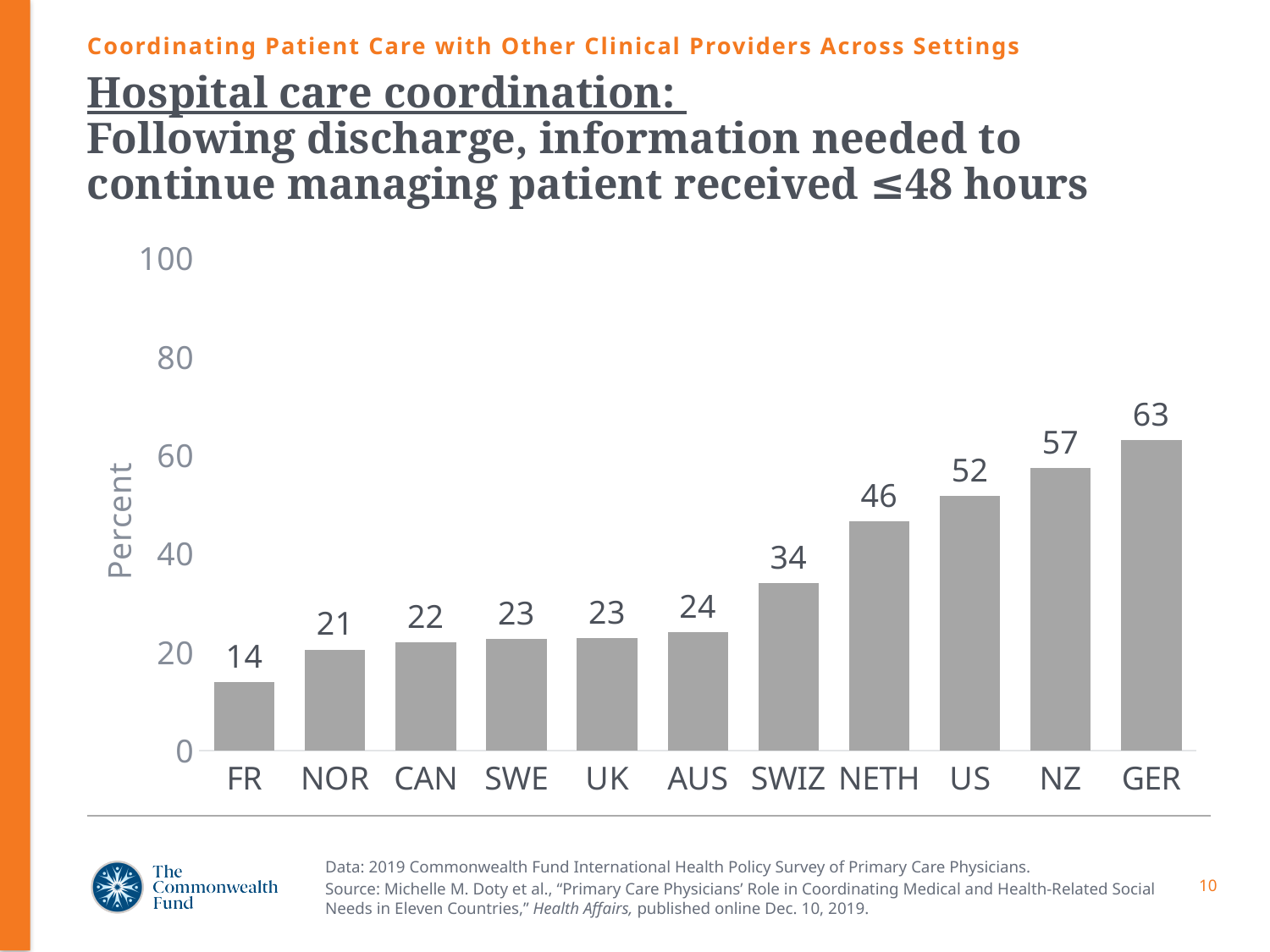
What kind of chart is shown on the slide? bar chart What is the value for FR? 14 What is the value for the US? 52 Is the value for NETH greater or less than 40? greater Which country has the lowest value? FR Which country has the highest value? GER What is the difference between the values for GER and FR? 49 How many countries are shown on the chart? 11 What is the label on the vertical axis? Percent Which is larger, the value for AUS or the value for SWIZ? SWIZ What is the difference between the values for NZ and NETH? 11 What is the value for SWIZ? 34